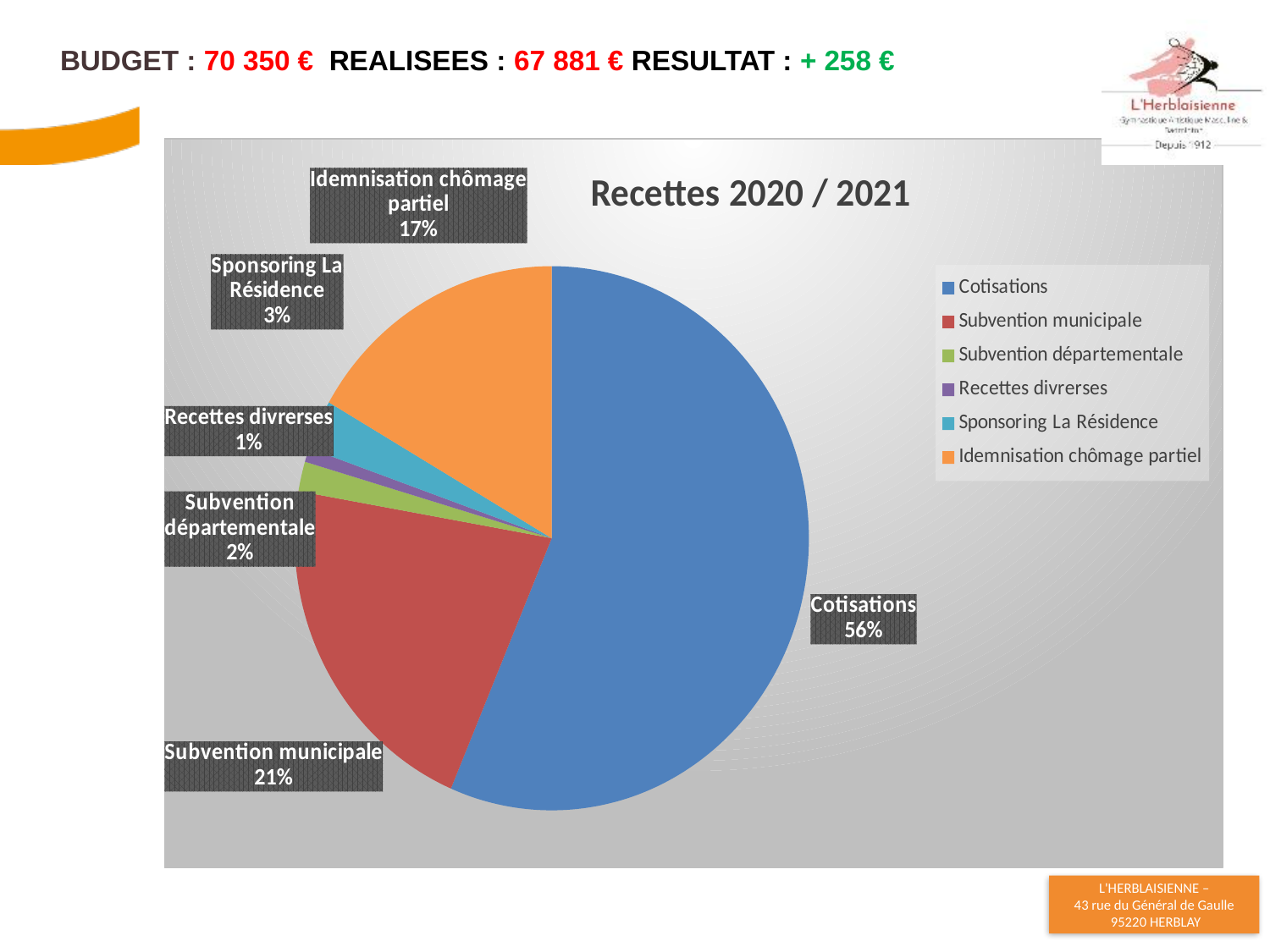
Which is larger, Subvention municipale or Idemnisation chômage partiel? Subvention municipale How many categories does the pie chart have? 6 What share of the pie does Subvention municipale represent? 21% Which category has the largest slice of the pie? Cotisations What is the difference in percentage points between Cotisations and Subvention municipale? 35 What share of the pie does Cotisations represent? 56% What is the title of the chart? Recettes 2020 / 2021 Which category has the smallest slice of the pie? Recettes divrerses What type of chart is shown on the slide? pie chart What share of the pie does Sponsoring La Résidence represent? 3%